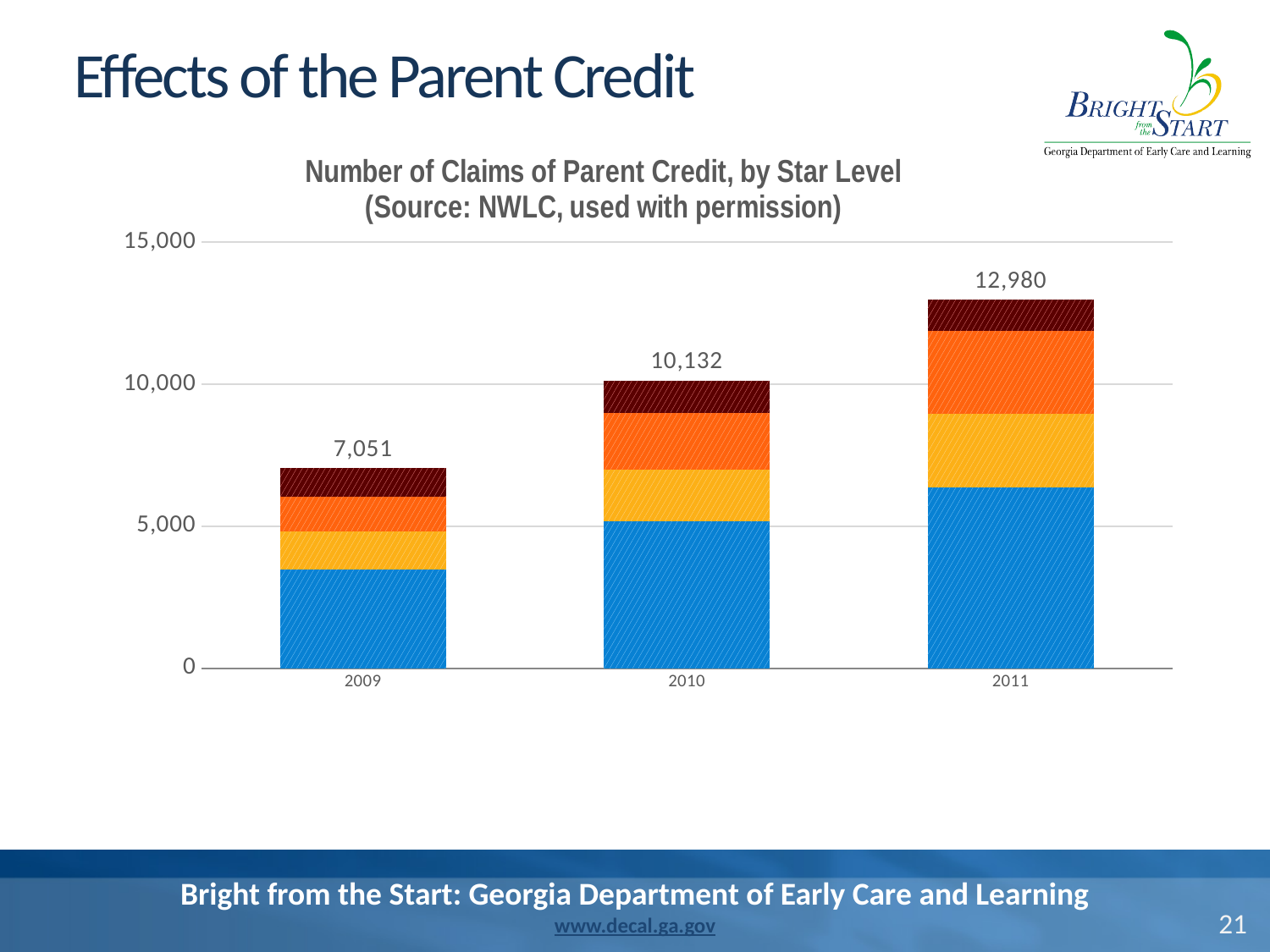
What is the total number of claims shown for 2009? 7,051 Do the total claims rise or fall from 2009 to 2011? Rise Which year has the highest total number of claims? 2011 Which year has the lowest total number of claims? 2009 What is the total number of claims shown for 2011? 12,980 What is the difference between the total claims in 2011 and 2009? 5,929 Which year has more total claims, 2010 or 2011? 2011 How many years are shown on the x axis? 3 What is the difference between the total claims in 2010 and 2009? 3,081 What kind of chart is shown on the slide? Stacked bar chart Is the blue (bottom) segment of the 2009 bar greater or less than 5,000? less What is the total number of claims shown for 2010? 10,132